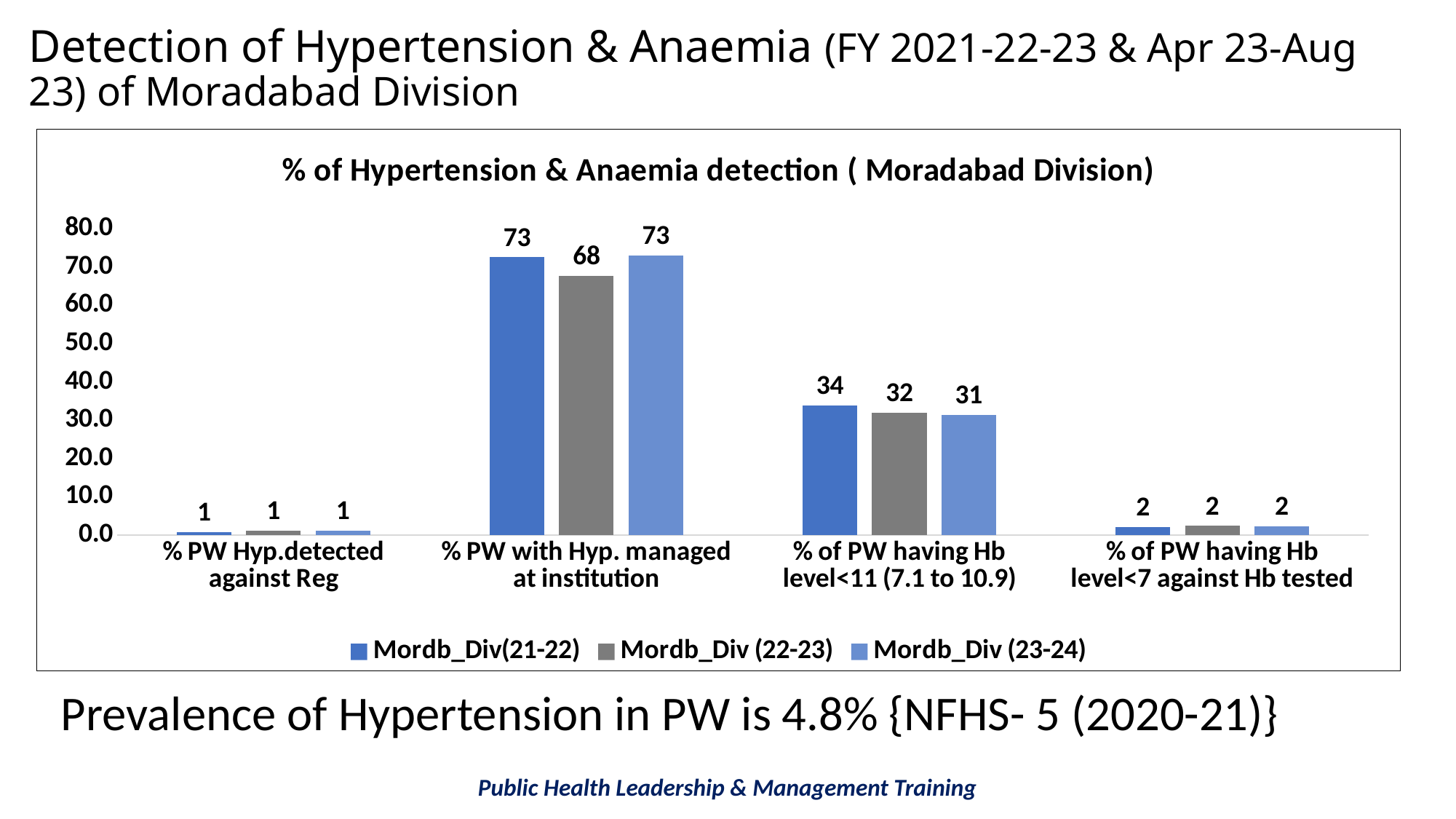
What is the value for Mordb_Div (22-23) in the '% PW with Hyp. managed at institution' category? 68 What is the difference between the Mordb_Div(21-22) and Mordb_Div (22-23) values in the '% PW with Hyp. managed at institution' category? 5 What kind of chart is shown on the slide? Bar chart Is the Mordb_Div (22-23) value for '% PW with Hyp. managed at institution' greater or less than 60.0? greater How many categories are shown on the x axis? 4 Which category has the highest values across all series? % PW with Hyp. managed at institution Which category has the lowest values across all series? % PW Hyp.detected against Reg How many series does the legend list? 3 What is the value for Mordb_Div (23-24) in the '% of PW having Hb level<7 against Hb tested' category? 2 In the '% of PW having Hb level<11 (7.1 to 10.9)' category, which series has the larger value: Mordb_Div(21-22) or Mordb_Div (23-24)? Mordb_Div(21-22) What is the title of the chart? % of Hypertension & Anaemia detection ( Moradabad Division) What is the value for Mordb_Div(21-22) in the '% of PW having Hb level<11 (7.1 to 10.9)' category? 34